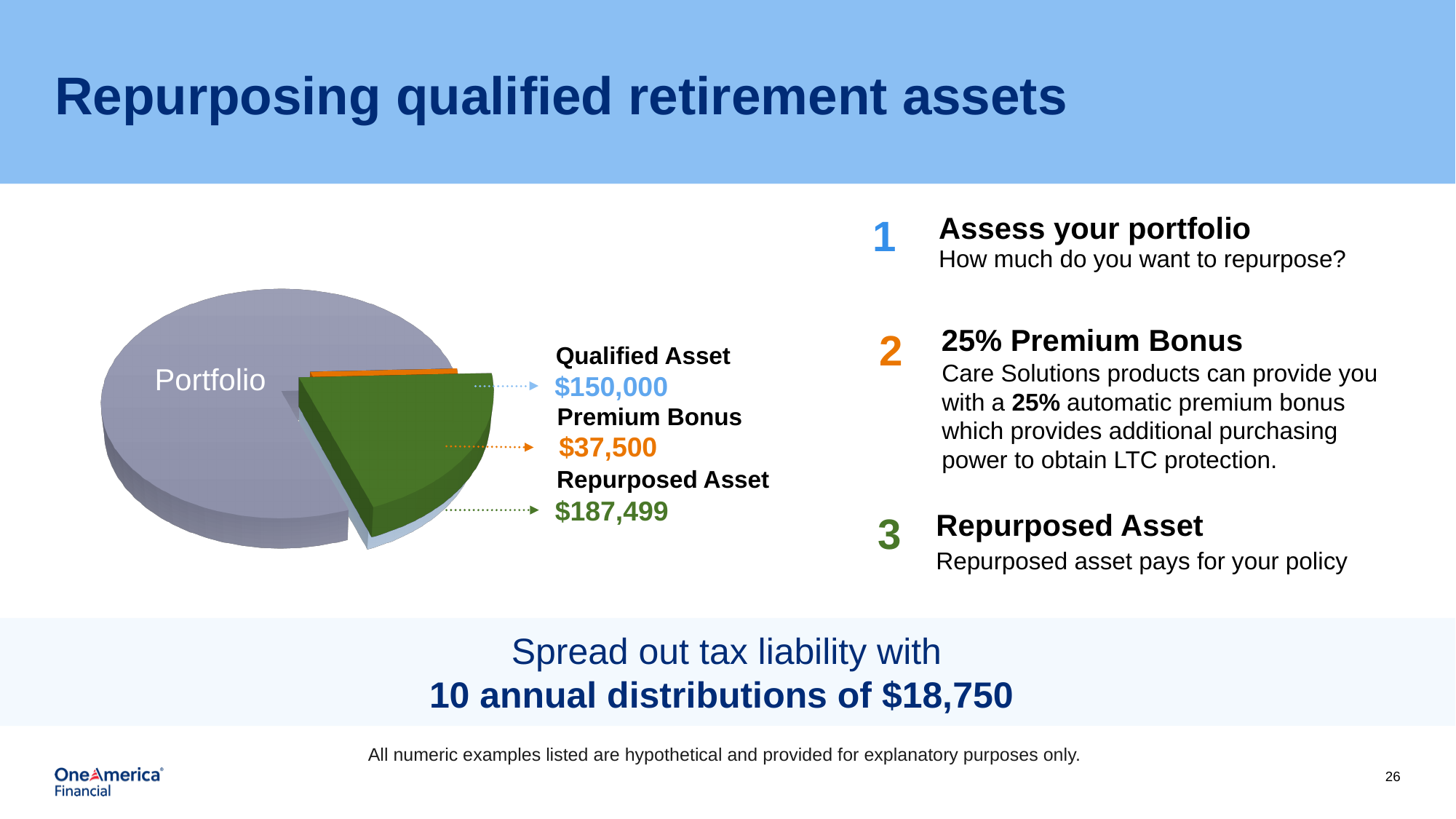
What is the difference between the Qualified Asset and the Premium Bonus values? $112,500 What type of chart is shown on the slide? Pie chart What label appears on the large grey slice of the pie chart? Portfolio What is the value shown for the Premium Bonus? $37,500 What is the value shown for the Qualified Asset? $150,000 What colour is used for the Premium Bonus layer of the exploded slice? Orange How many labelled dollar values are shown next to the chart? 3 Which of the three labelled values on the chart is the largest? Repurposed Asset Which is larger, the Qualified Asset or the Premium Bonus? Qualified Asset What is the value shown for the Repurposed Asset? $187,499 Which of the three labelled values on the chart is the smallest? Premium Bonus